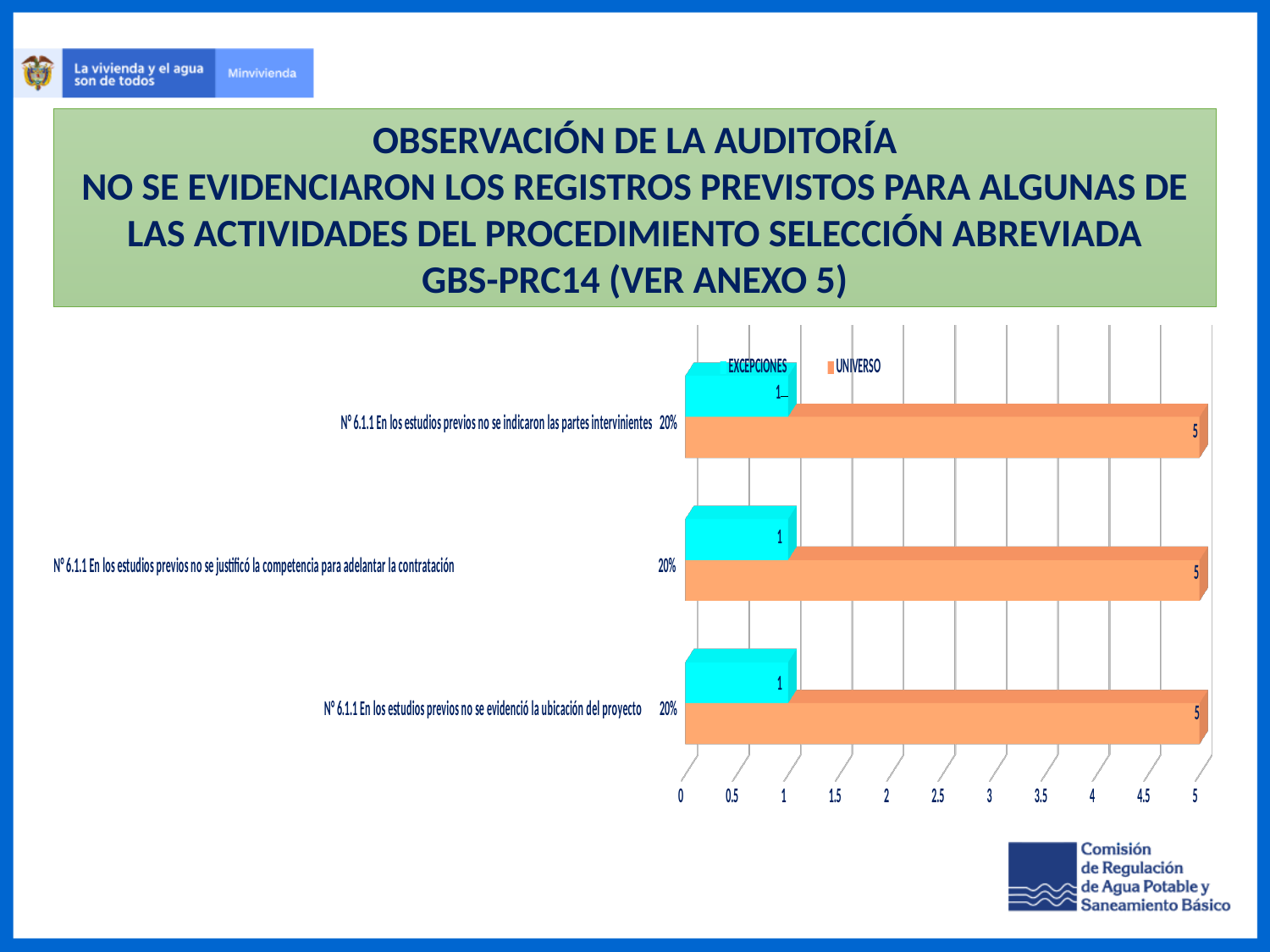
How many categories are plotted on the chart? 3 What kind of chart is shown on the slide? bar chart Is the EXCEPCIONES value for 'N° 6.1.1 En los estudios previos no se evidenció la ubicación del proyecto' greater or less than 2? less What is the UNIVERSO value for 'N° 6.1.1 En los estudios previos no se evidenció la ubicación del proyecto'? 5 How many series does the chart legend list? 2 What is the difference between the UNIVERSO and EXCEPCIONES values for 'N° 6.1.1 En los estudios previos no se evidenció la ubicación del proyecto'? 4 What is the highest value shown on the chart's horizontal axis? 5 What colour are the UNIVERSO bars in the chart? orange What is the UNIVERSO value for 'N° 6.1.1 En los estudios previos no se indicaron las partes intervinientes'? 5 Is the UNIVERSO value for 'N° 6.1.1 En los estudios previos no se justificó la competencia para adelantar la contratación' greater or less than 3? greater Which series has the larger value for 'N° 6.1.1 En los estudios previos no se indicaron las partes intervinientes', EXCEPCIONES or UNIVERSO? UNIVERSO What is the EXCEPCIONES value for 'N° 6.1.1 En los estudios previos no se justificó la competencia para adelantar la contratación'? 1